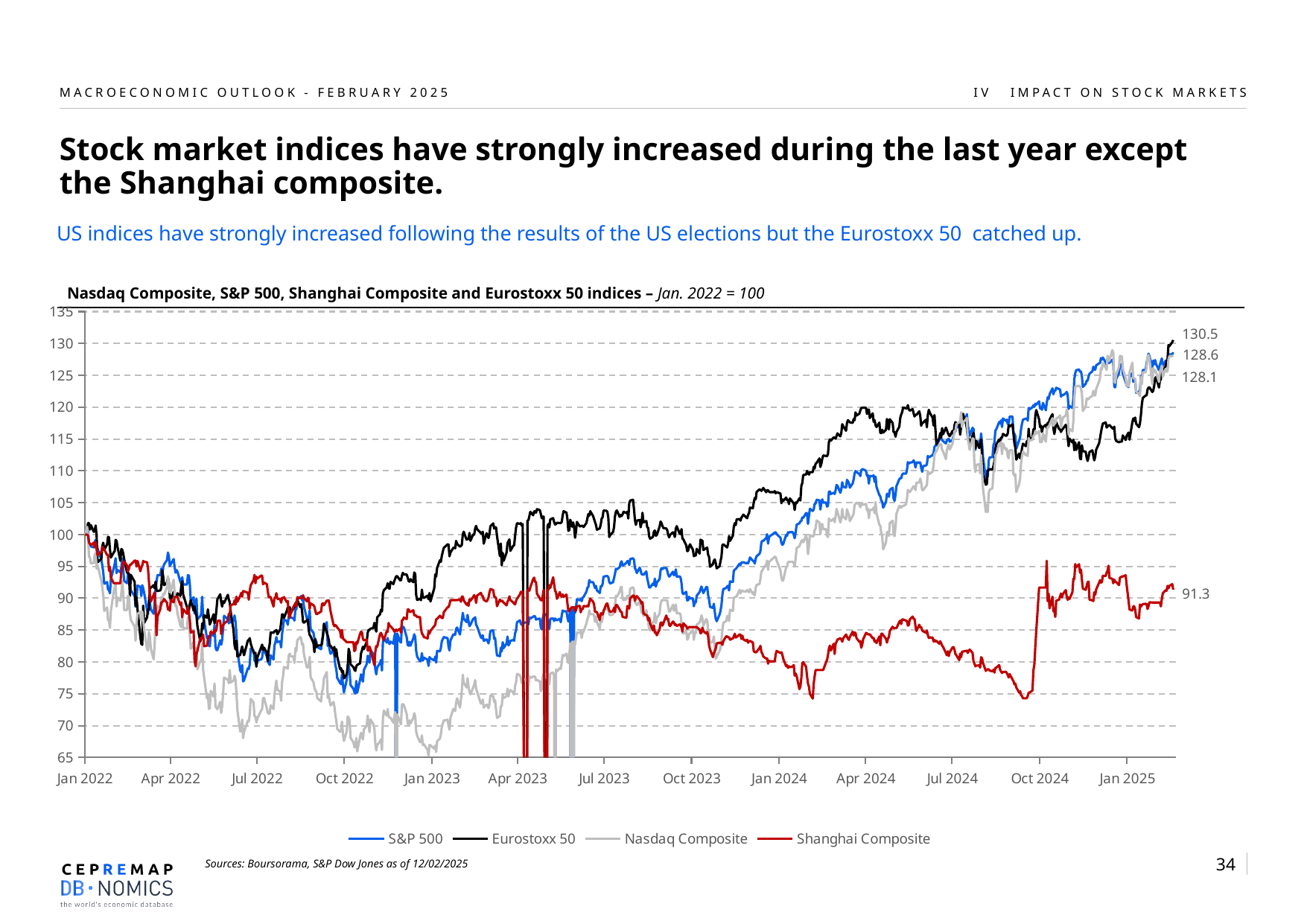
At the end of the series, which is larger: the Eurostoxx 50 or the Shanghai Composite? Eurostoxx 50 How many series does the legend list? 4 Is the value of the S&P 500 in Jan 2025 greater or less than 120? greater Which index has the highest value at the end of the series? Eurostoxx 50 What kind of chart is shown on the slide? line chart What is the difference between the latest Eurostoxx 50 value and the latest Shanghai Composite value? 39.2 Does the Shanghai Composite index rise or fall overall between Jan 2022 and the end of the series? fall Which index has the lowest value at the end of the series? Shanghai Composite What is the latest value shown for the Shanghai Composite index? 91.3 Is the latest value of the Shanghai Composite greater or less than 100? less What is the latest value shown for the Eurostoxx 50 index? 130.5 What base period is used for the indices in the chart? Jan. 2022 = 100